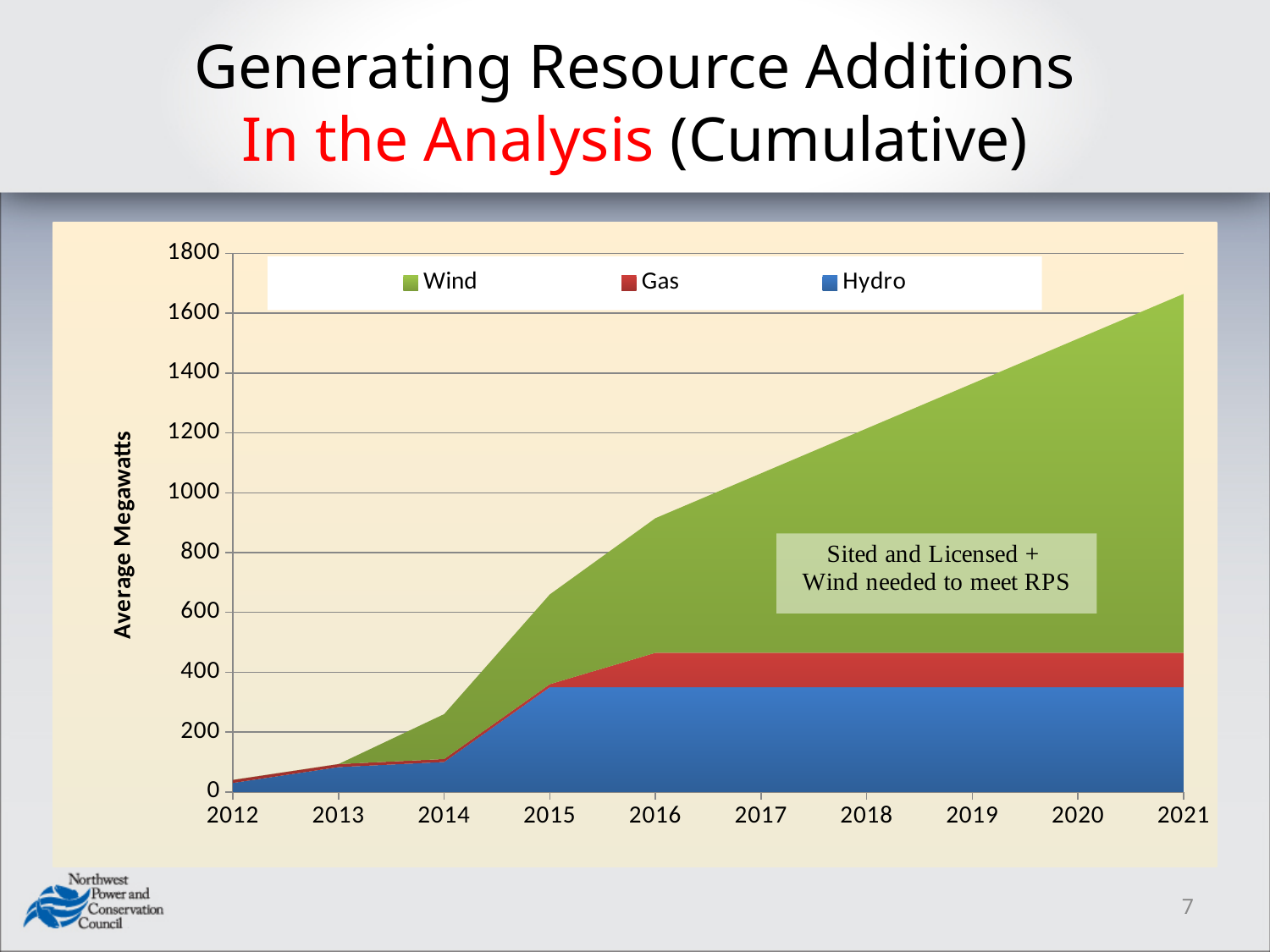
Is the total cumulative value in 2016 greater or less than 800? greater Is the total cumulative value in 2021 greater or less than 1400? greater Does the total cumulative resource addition rise or fall from 2012 to 2021? Rises What kind of chart is shown on the slide? Stacked area chart Which series accounts for the largest share of the total in 2021? Wind What is the label of the y axis? Average Megawatts Is the Hydro value in 2021 greater or less than 400? less Which series are listed in the legend? Wind, Gas, Hydro Which series is larger in 2021, Gas or Hydro? Hydro How many series does the legend list? 3 How many years are shown along the x axis? 10